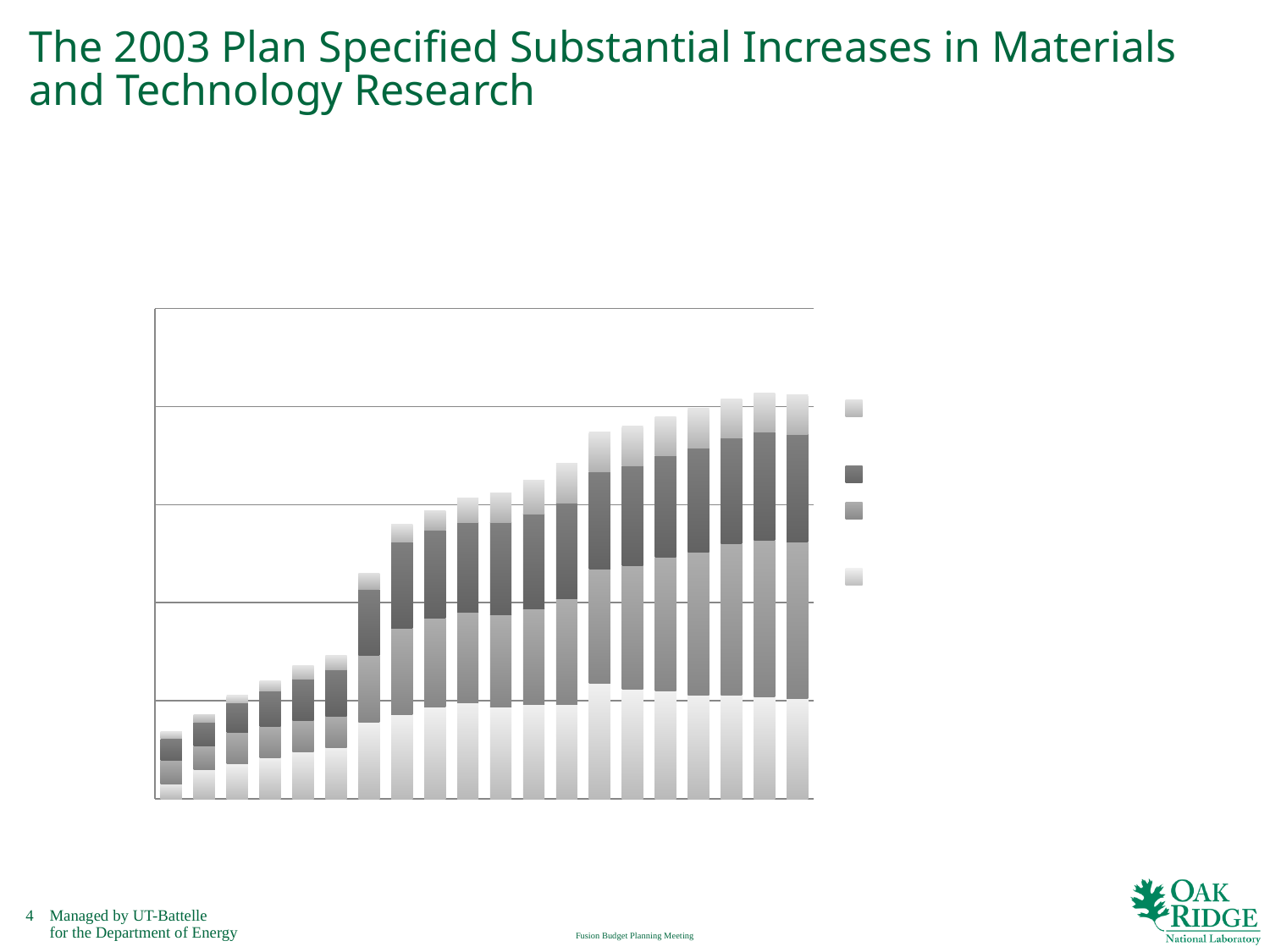
How many bars are plotted in the chart? 20 How many series does the chart's legend list? 4 How many horizontal gridlines are drawn inside the plot area above the baseline? 5 Are the bars in the chart vertical or horizontal? vertical What kind of chart is shown on the slide? stacked bar chart Do the total bar heights generally rise or fall from left to right along the x axis? rise